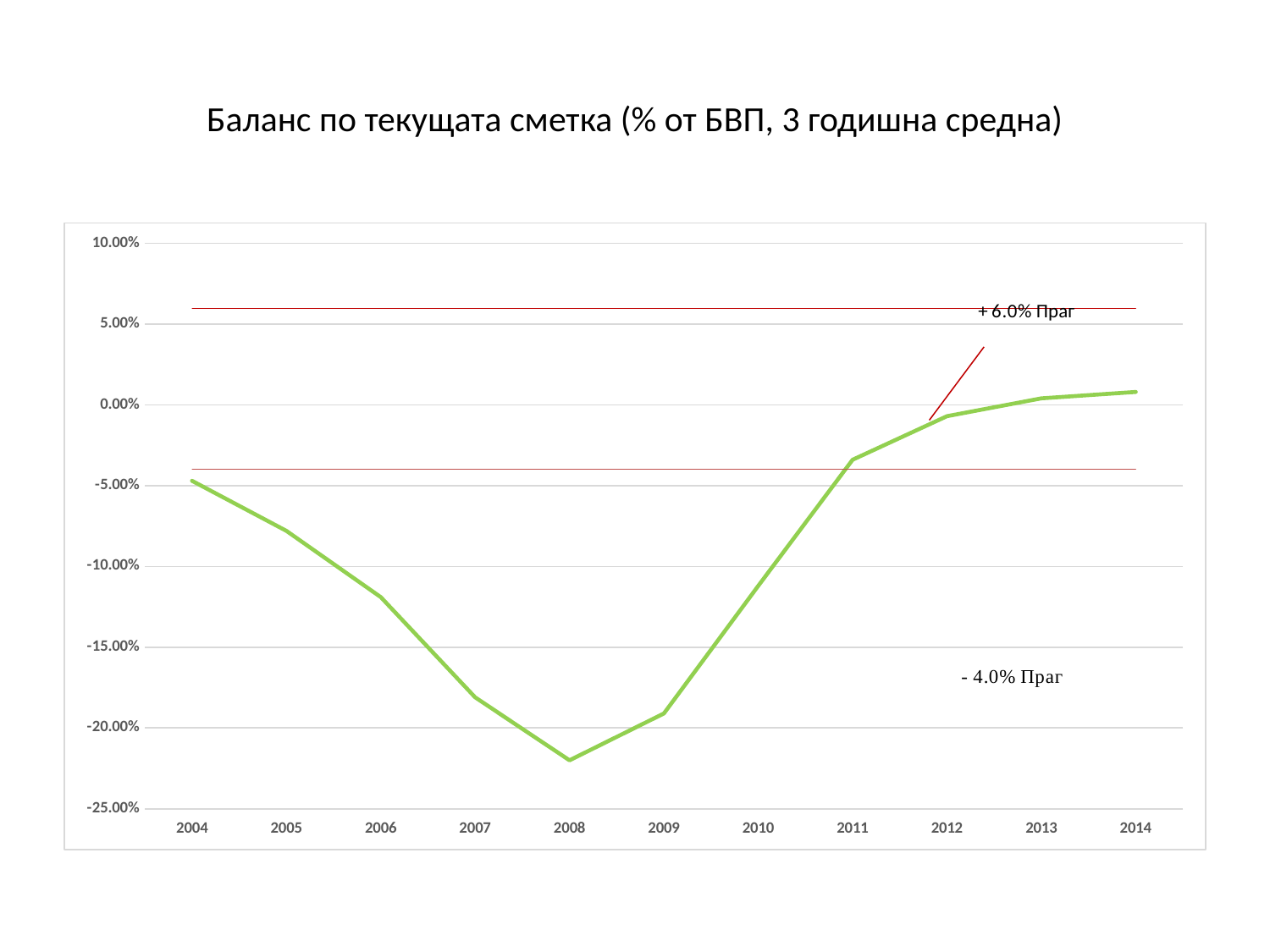
What is the label on the upper red threshold line? + 6.0% Праг Which year has the larger value, 2005 or 2007? 2005 Is the value for 2008 greater or less than -20.00%? less In which year does the green line reach its lowest value? 2008 Is the value for 2011 greater or less than -5.00%? greater How many years are plotted along the x axis? 11 Is the value for 2006 greater or less than -10.00%? less Does the green line rise or fall from 2008 to 2014? rise What is the title of the chart? Баланс по текущата сметка (% от БВП, 3 годишна средна) What kind of chart is shown on the slide? line chart